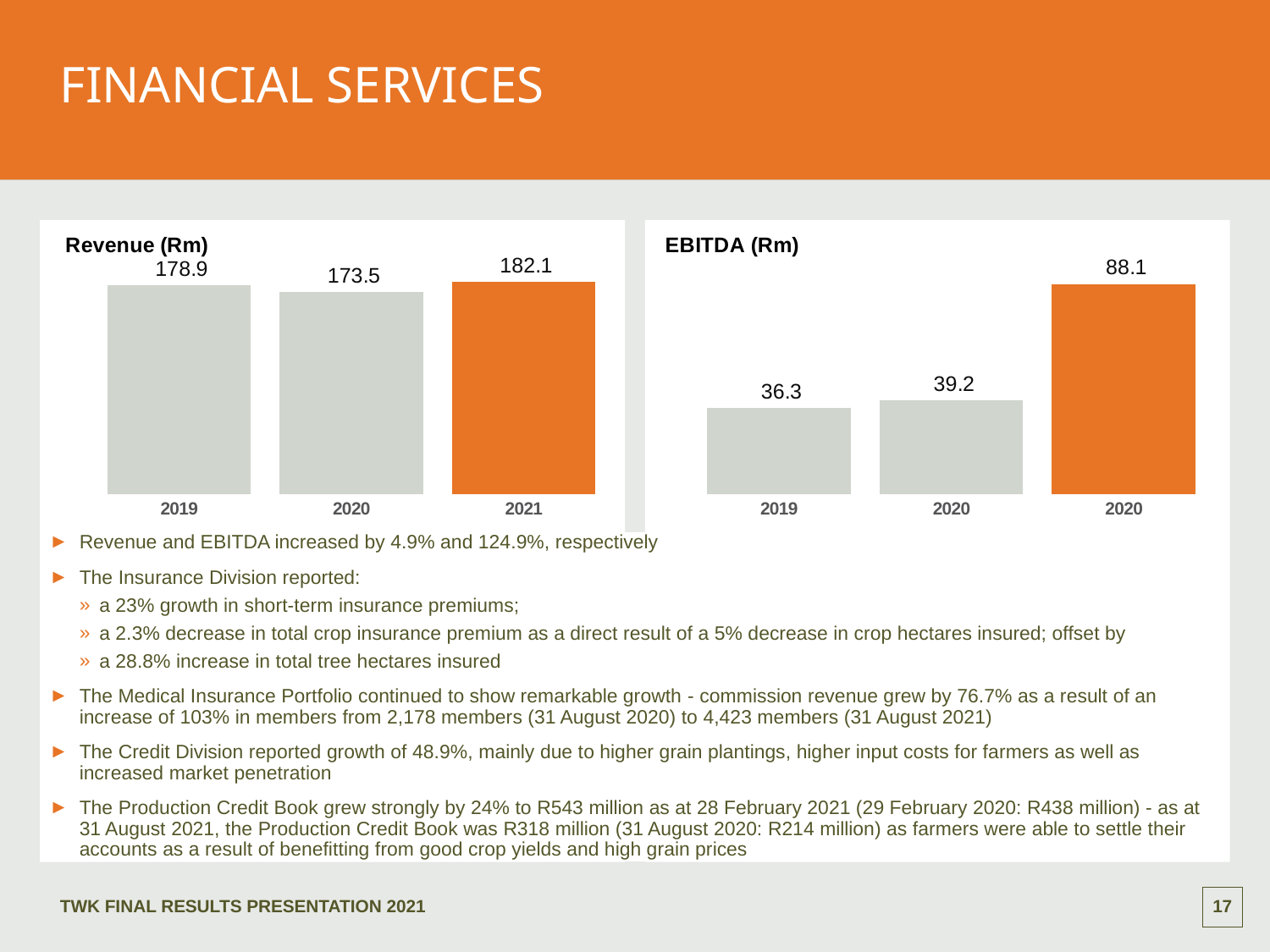
In the Revenue (Rm) chart, which year has the lowest value? 2020 In the Revenue (Rm) chart, which is larger, the value for 2019 or the value for 2020? 2019 In the Revenue (Rm) chart, what is the value for 2021? 182.1 In the EBITDA (Rm) chart, what is the value shown on the orange (rightmost) bar? 88.1 In the EBITDA (Rm) chart, what is the value for 2019? 36.3 In the EBITDA (Rm) chart, what is the difference between the rightmost bar (88.1) and the 2019 bar? 51.8 In the Revenue (Rm) chart, what is the value for 2019? 178.9 In the Revenue (Rm) chart, what is the difference between the 2021 and 2020 values? 8.6 What type of chart is the Revenue (Rm) chart? Bar chart In the EBITDA (Rm) chart, do the values rise or fall from left to right? Rise In the Revenue (Rm) chart, which year has the highest value? 2021 How many bars are in the EBITDA (Rm) chart? 3